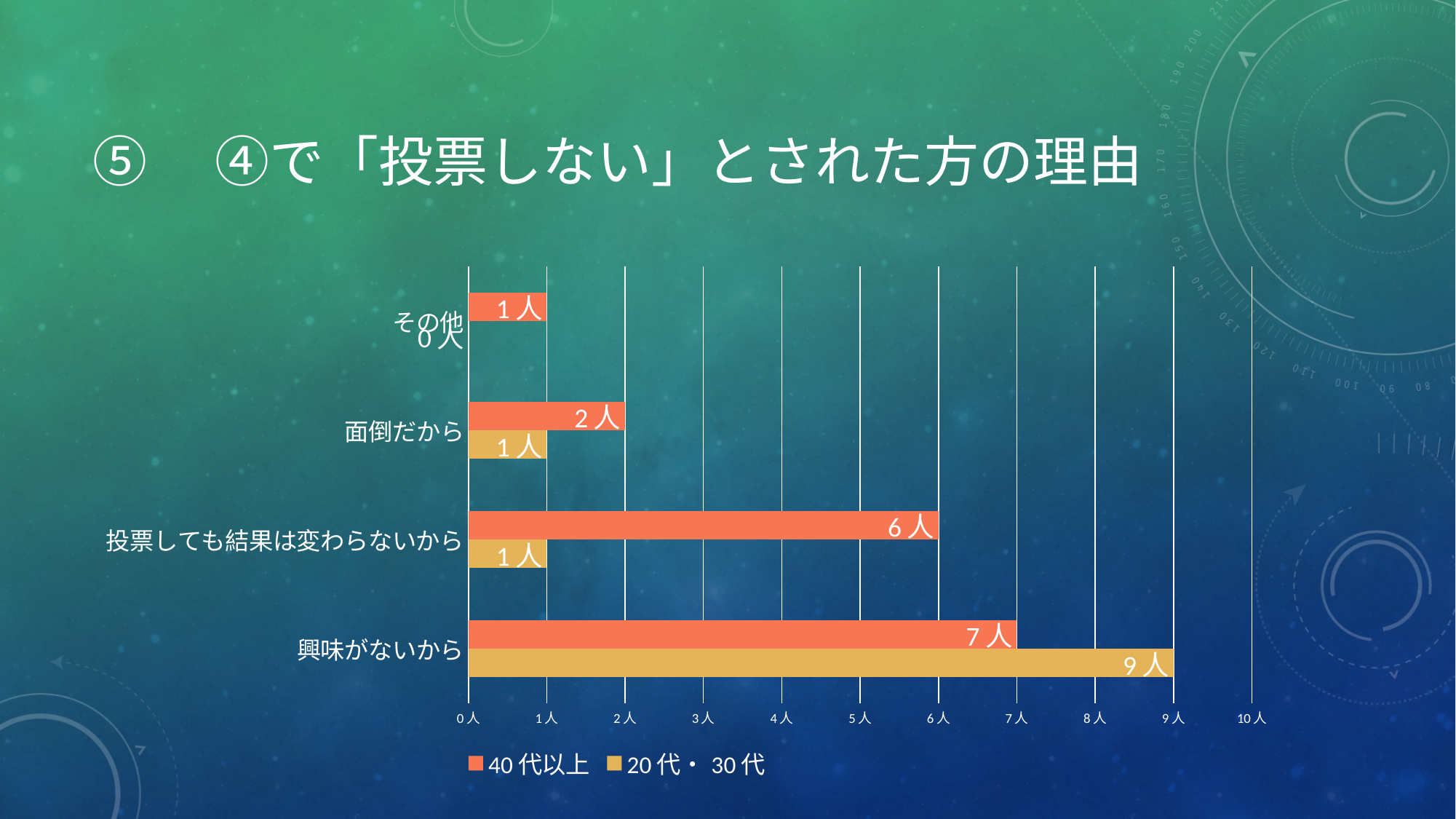
How many categories are shown on the chart? 4 What is the value for 40代以上 in the 興味がないから category? 7人 What is the value for 20代・30代 in the 面倒だから category? 1人 What is the value for 40代以上 in the 投票しても結果は変わらないから category? 6人 How many series does the legend list? 2 Which category has the highest value for the 20代・30代 series? 興味がないから What kind of chart is shown on the slide? Bar chart What is the difference between the 40代以上 and 20代・30代 values in the 投票しても結果は変わらないから category? 5人 Which category has the lowest value for the 40代以上 series? その他 In the 興味がないから category, which series has the larger value, 40代以上 or 20代・30代? 20代・30代 What is the value for 20代・30代 in the その他 category? 0人 What is the value for 20代・30代 in the 興味がないから category? 9人